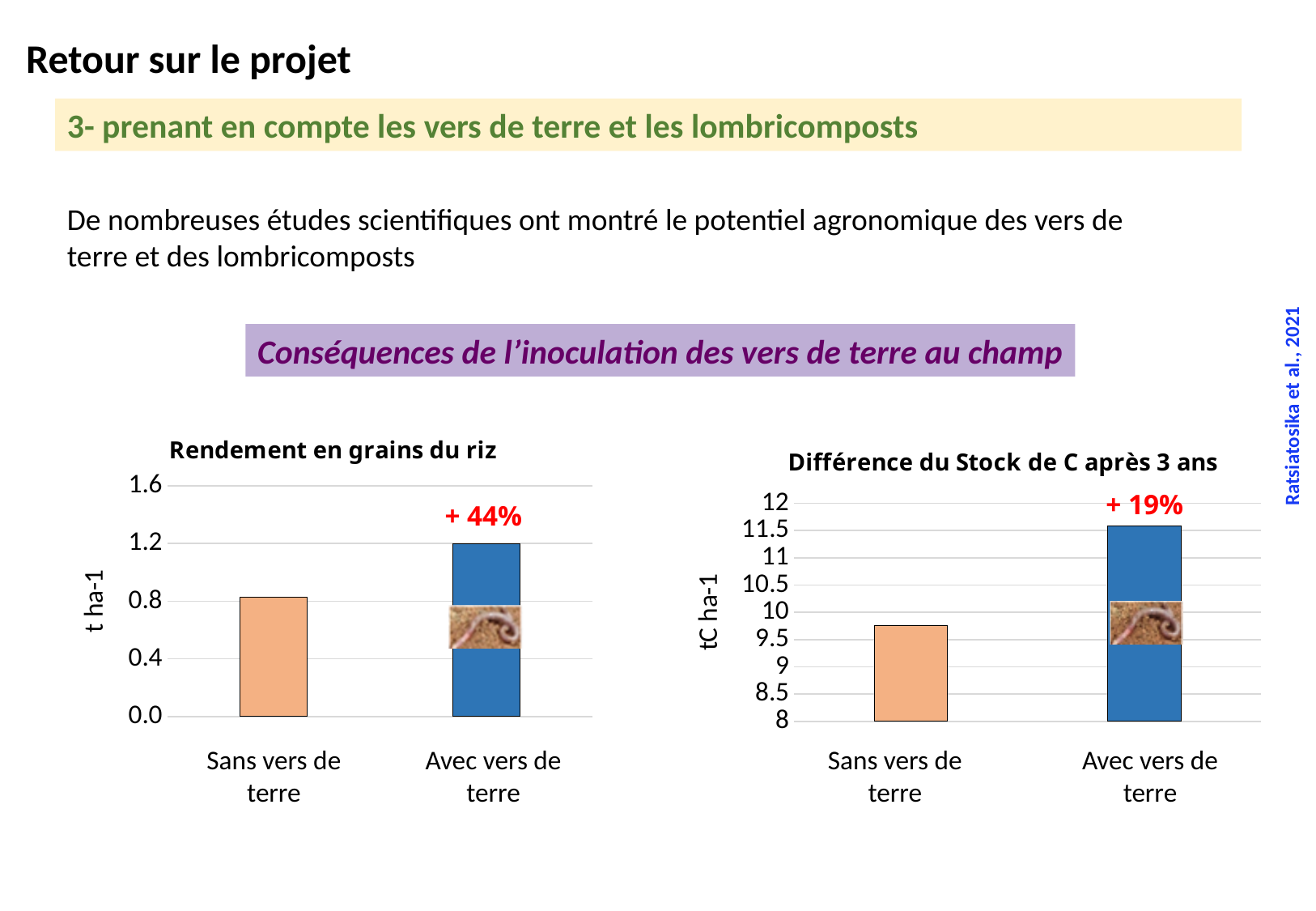
In the chart titled 'Rendement en grains du riz', is the value for 'Sans vers de terre' greater or less than 0.4? greater In the chart titled 'Différence du Stock de C après 3 ans', is the value for 'Sans vers de terre' greater or less than 10? less In the chart titled 'Rendement en grains du riz', which category has the higher value? Avec vers de terre In the chart titled 'Rendement en grains du riz', is the value for 'Sans vers de terre' greater or less than 1.2? less What kind of chart is the chart titled 'Différence du Stock de C après 3 ans'? bar chart In the chart titled 'Rendement en grains du riz', how many categories are shown on the x axis? 2 In the chart titled 'Différence du Stock de C après 3 ans', which category has the higher value? Avec vers de terre In the chart titled 'Rendement en grains du riz', which category has the lower value? Sans vers de terre In the chart titled 'Rendement en grains du riz', what percentage increase is annotated above the 'Avec vers de terre' bar? + 44% What is the y-axis label of the chart titled 'Rendement en grains du riz'? t ha-1 In the chart titled 'Différence du Stock de C après 3 ans', what percentage increase is annotated above the 'Avec vers de terre' bar? + 19%